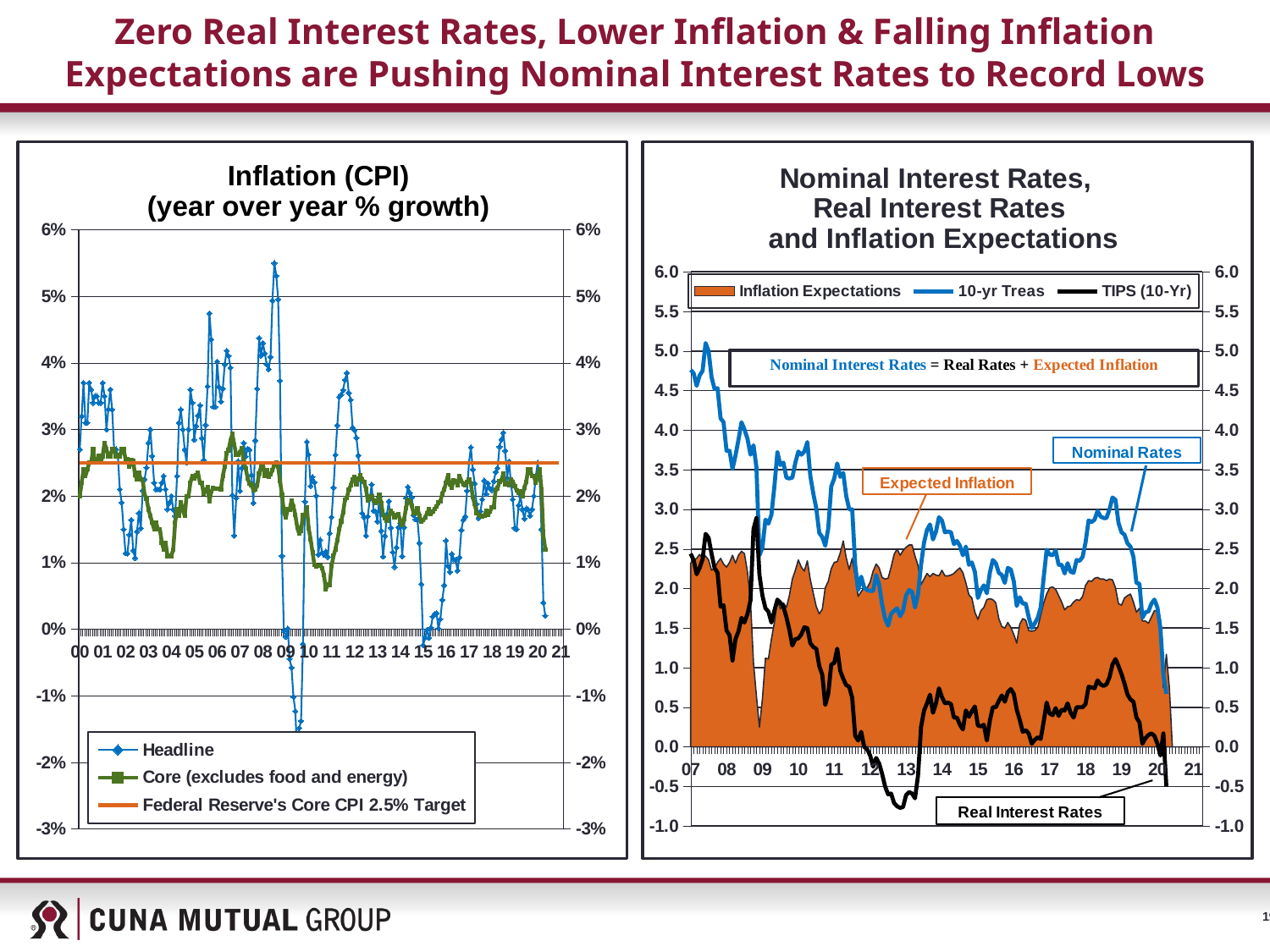
On the Inflation (CPI) chart, what value is the Federal Reserve's Core CPI target line drawn at? 2.5% On the Nominal Interest Rates chart, does the 10-yr Treasury series overall rise or fall from 2007 to 2020? Fall On the Nominal Interest Rates chart, is the lowest TIPS (10-Yr) value around 2012-2013 greater or less than 0.0? less On the Nominal Interest Rates chart, is the peak 10-yr Treasury value in 2007 greater or less than 4.5? greater On the Inflation (CPI) chart, does the Core series ever fall below 0%? No On the Nominal Interest Rates, Real Interest Rates and Inflation Expectations chart, how many series does the legend list? 3 On the Inflation (CPI) chart, how many series does the legend list? 3 On the Nominal Interest Rates chart, what equation is shown in the text box? Nominal Interest Rates = Real Rates + Expected Inflation On the Nominal Interest Rates chart, which series is drawn as a filled orange area? Inflation Expectations What kind of chart is the Inflation (CPI) chart? Line chart